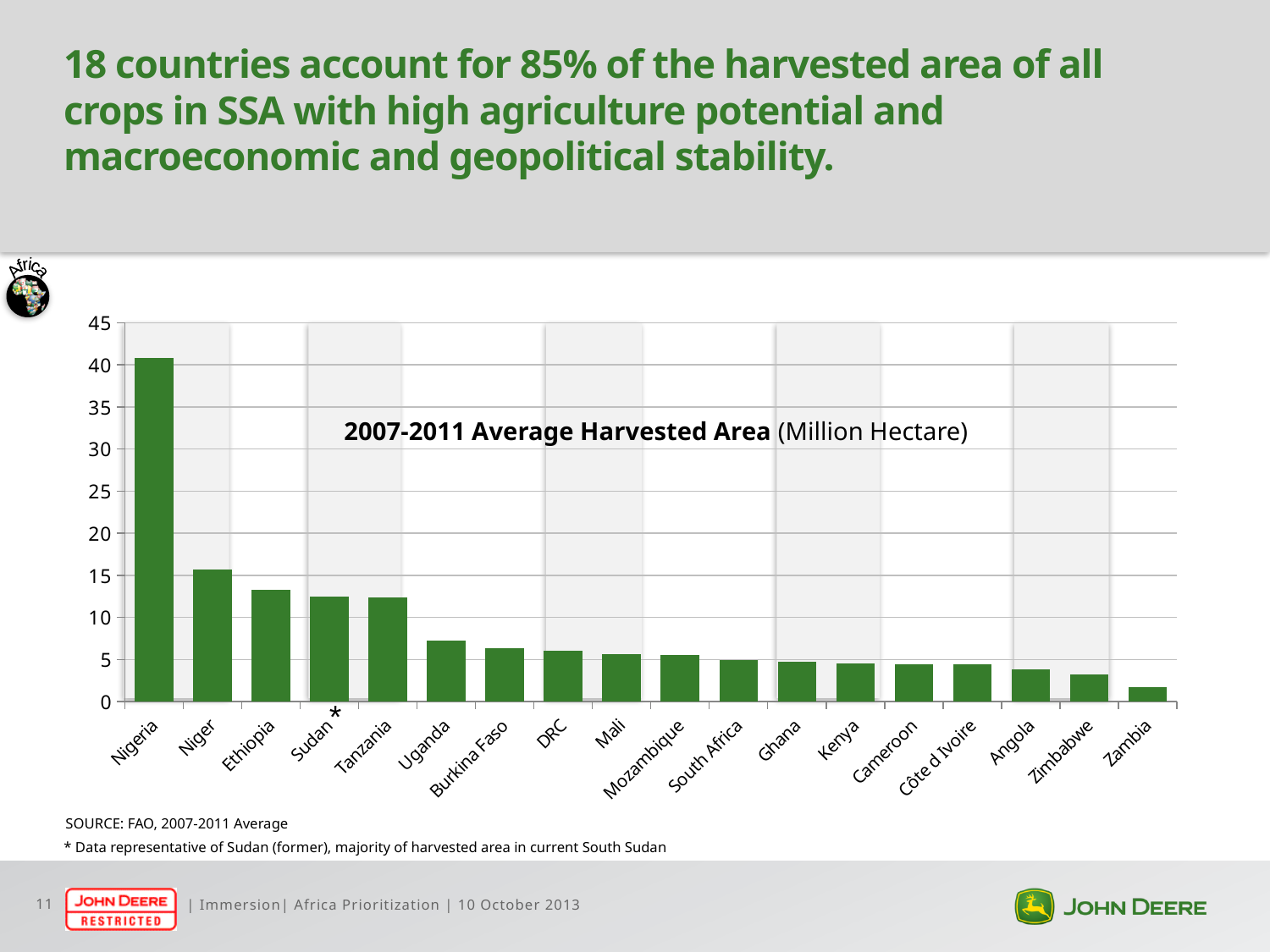
Is the value for Niger greater or less than 10? greater Which country has the highest average harvested area in the chart? Nigeria Is the value for Nigeria greater or less than 35? greater Is the value for Ethiopia greater or less than 15? less Which country has the lowest average harvested area in the chart? Zambia Do the bar values rise or fall moving from left to right along the x axis? Fall Which has a larger average harvested area, Niger or Ethiopia? Niger What kind of chart is shown on the slide? Bar chart What is the title of the chart? 2007-2011 Average Harvested Area (Million Hectare) How many countries are shown on the x axis of the chart? 18 Which country's label is marked with an asterisk in the chart? Sudan